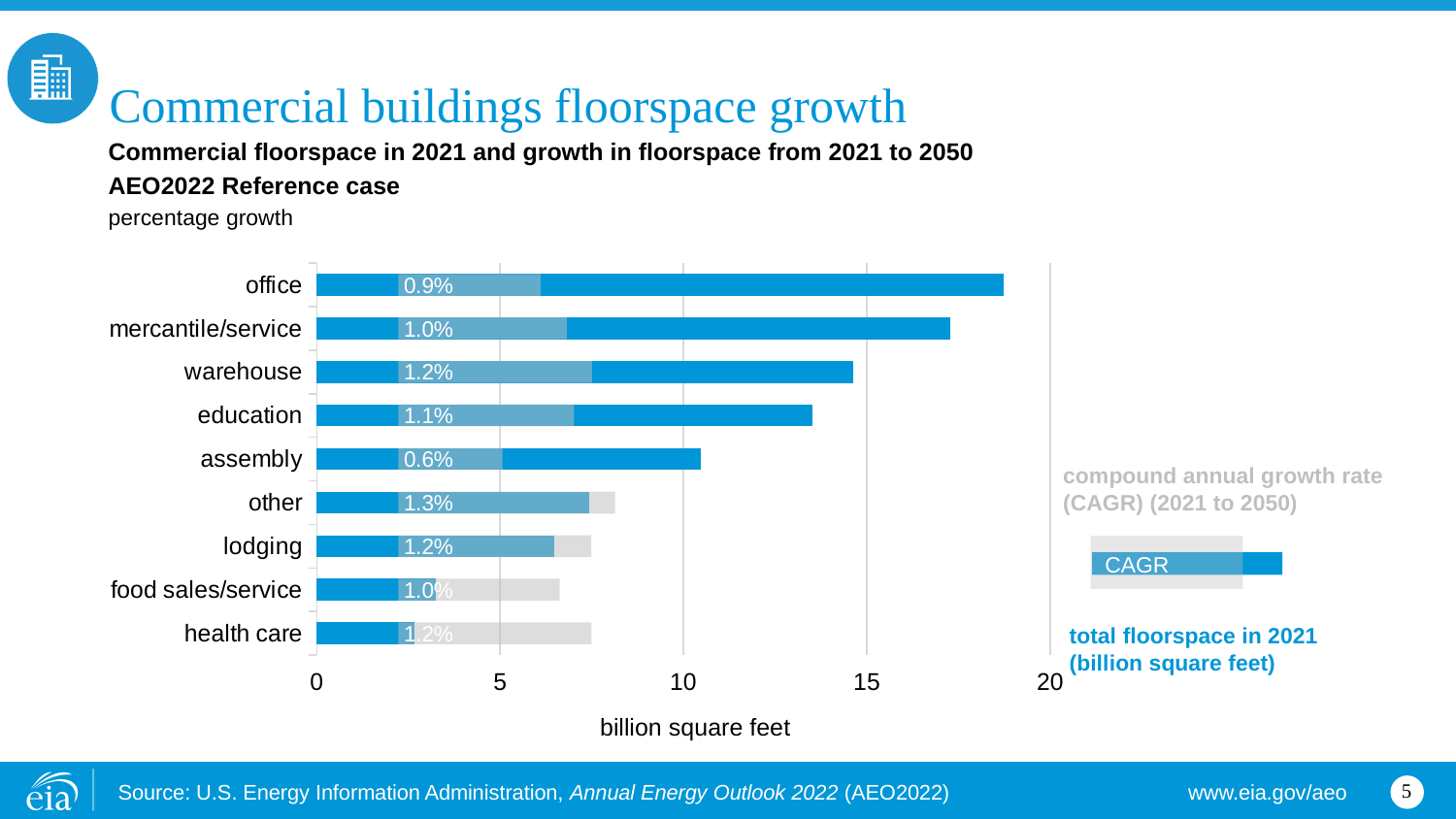
What CAGR is labeled on the bar for education? 1.1% Is the total floorspace in 2021 for health care greater or less than 10 billion square feet? less Which building type has the highest CAGR label? other What unit is labeled on the horizontal axis of the chart? billion square feet Is the total floorspace in 2021 for office greater or less than 15 billion square feet? greater What is the compound annual growth rate (CAGR) shown for office floorspace? 0.9% What CAGR is labeled on the bar for warehouse? 1.2% What is the difference between the CAGR for other and the CAGR for assembly? 0.7 percentage points Which has more total floorspace in 2021, office or assembly? office Which building type has the lowest CAGR label? assembly What kind of chart is shown on the slide? bar chart How many building types are shown on the chart? 9